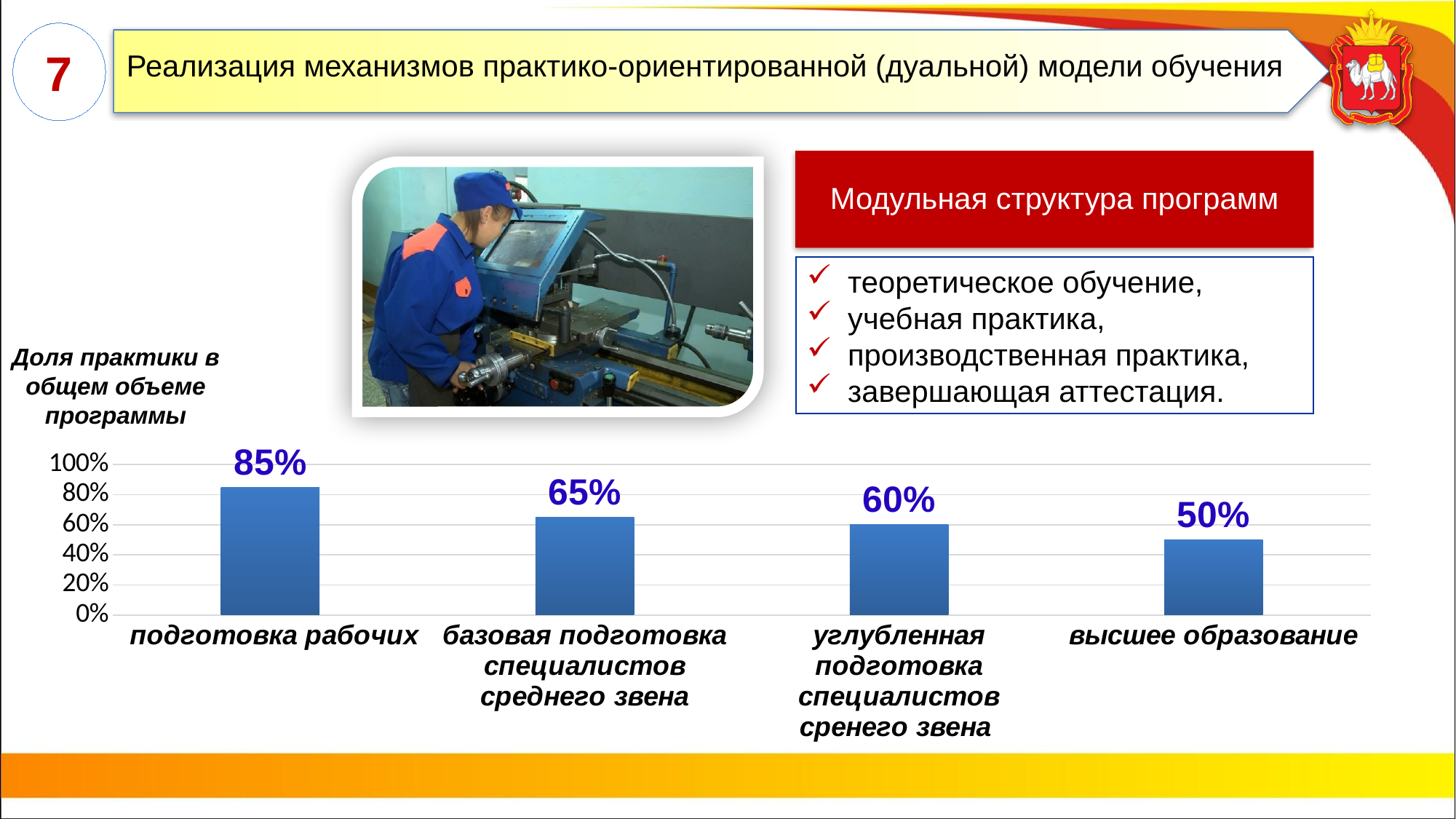
What is the value for высшее образование? 50% Which category has the highest value? подготовка рабочих What kind of chart is shown on the slide? bar chart Which is larger: the value for базовая подготовка специалистов среднего звена or углубленная подготовка специалистов сренего звена? базовая подготовка специалистов среднего звена What is the difference between the values for подготовка рабочих and высшее образование? 35% How many categories are shown in the chart? 4 Which category has the lowest value? высшее образование What is the label to the left of the chart describing what the values represent? Доля практики в общем объеме программы What is the value for углубленная подготовка специалистов сренего звена? 60% What is the value for базовая подготовка специалистов среднего звена? 65% What is the value for подготовка рабочих? 85% Do the values rise or fall from left to right along the x axis? fall